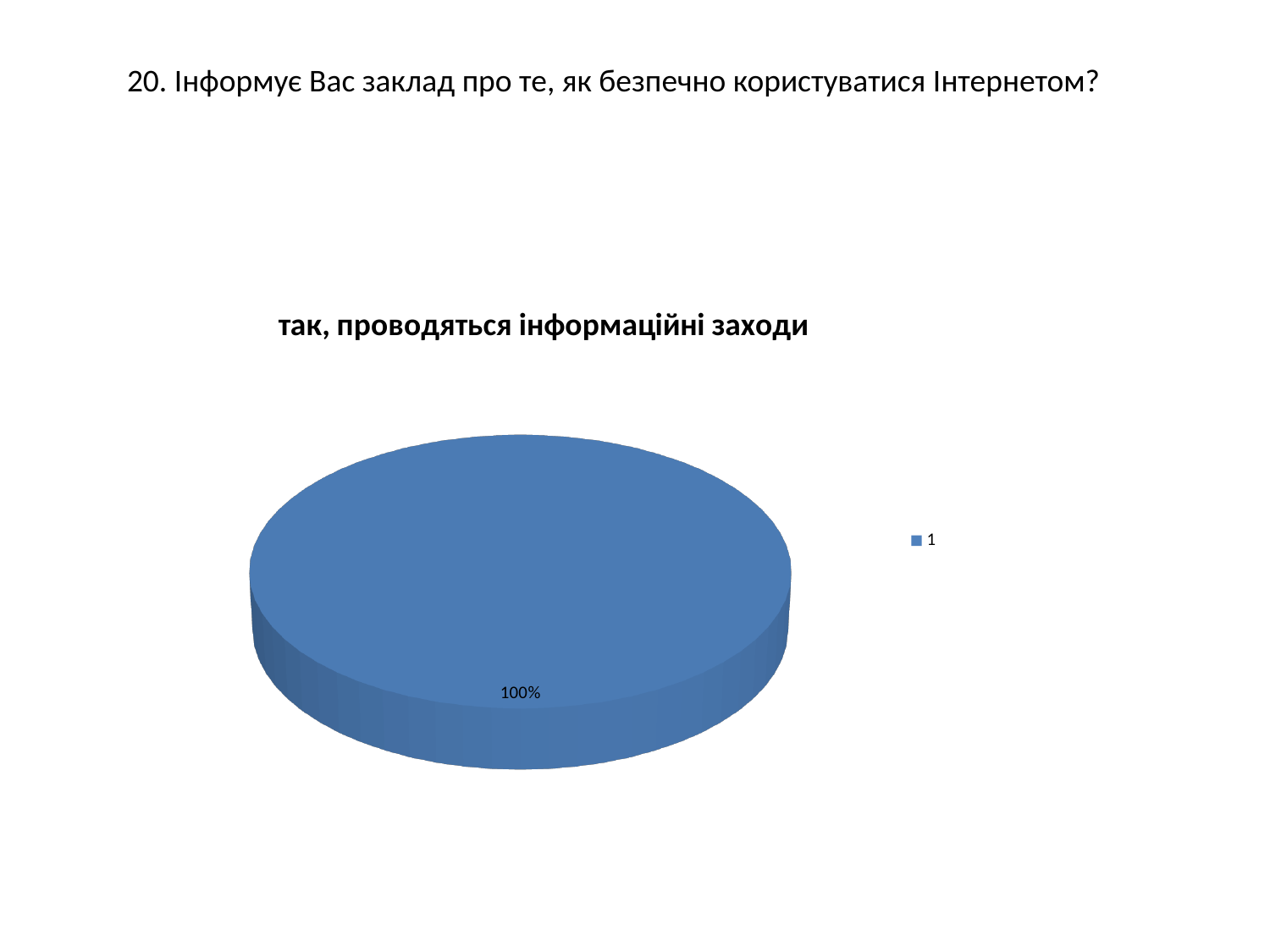
What is the title of the chart? так, проводяться інформаційні заходи What share of the pie does the single slice take? 100% What kind of chart is shown on the slide? pie chart What is the data label shown on the pie slice? 100% How many entries does the legend list? 1 How many slices does the pie chart have? 1 What is the legend entry for the slice? 1